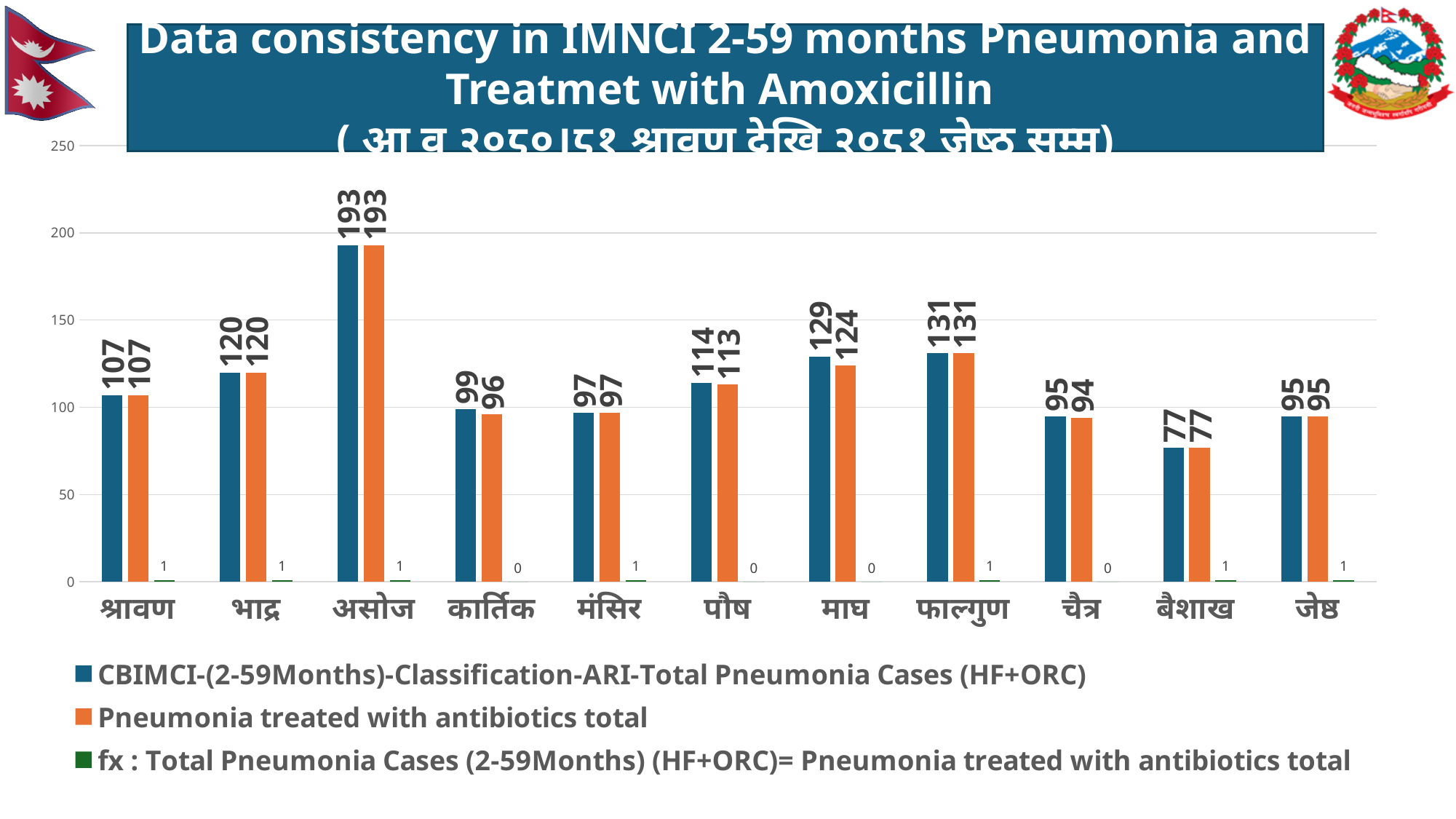
Which month has the highest value for CBIMCI-(2-59Months)-Classification-ARI-Total Pneumonia Cases (HF+ORC)? असोज What kind of chart is shown on the slide? Bar chart How many months are shown on the x axis? 11 What is the value of Pneumonia treated with antibiotics total for कार्तिक? 96 Which month has the lowest value for Pneumonia treated with antibiotics total? बैशाख Is the value of CBIMCI-(2-59Months)-Classification-ARI-Total Pneumonia Cases (HF+ORC) for फाल्गुण greater or less than 100? greater What is the value of CBIMCI-(2-59Months)-Classification-ARI-Total Pneumonia Cases (HF+ORC) for असोज? 193 How many series does the legend list? 3 What is the value of Pneumonia treated with antibiotics total for माघ? 124 Which is larger for पौष: CBIMCI-(2-59Months)-Classification-ARI-Total Pneumonia Cases (HF+ORC) or Pneumonia treated with antibiotics total? CBIMCI-(2-59Months)-Classification-ARI-Total Pneumonia Cases (HF+ORC) What is the difference between CBIMCI-(2-59Months)-Classification-ARI-Total Pneumonia Cases (HF+ORC) and Pneumonia treated with antibiotics total for माघ? 5 What is the value of the fx series for कार्तिक? 0